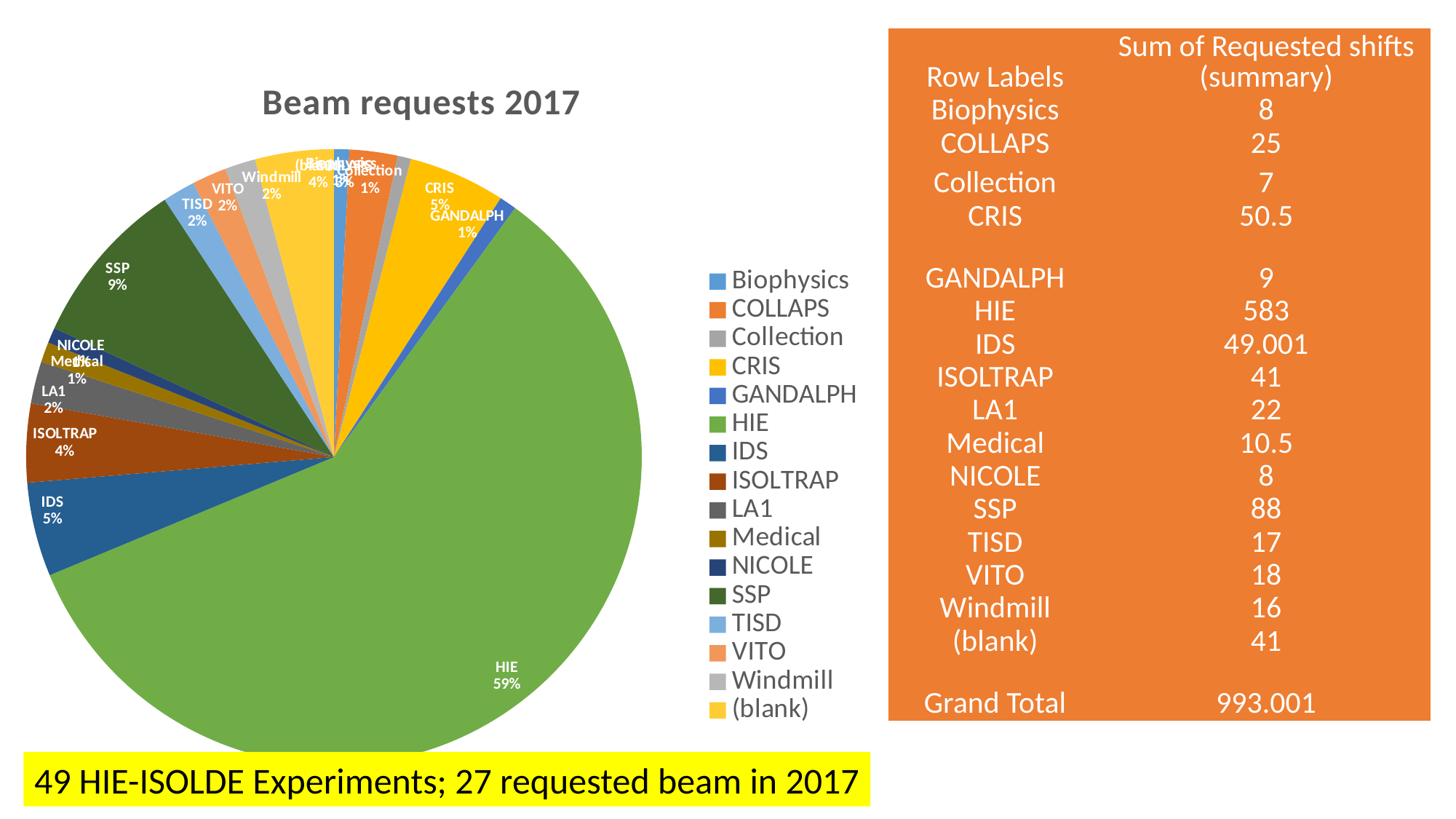
What kind of chart is shown on the slide? pie chart What percentage is shown for SSP? 9% Which slice is larger, SSP or IDS? SSP What percentage is shown for LA1? 2% What percentage is shown for CRIS? 5% What share of the pie does HIE account for? 59% What percentage is shown for IDS? 5% What is the title of the chart? Beam requests 2017 How many entries does the chart's legend list? 16 Which category has the largest slice of the pie? HIE What percentage is shown for ISOLTRAP? 4% By how many percentage points does the HIE slice exceed the SSP slice? 50